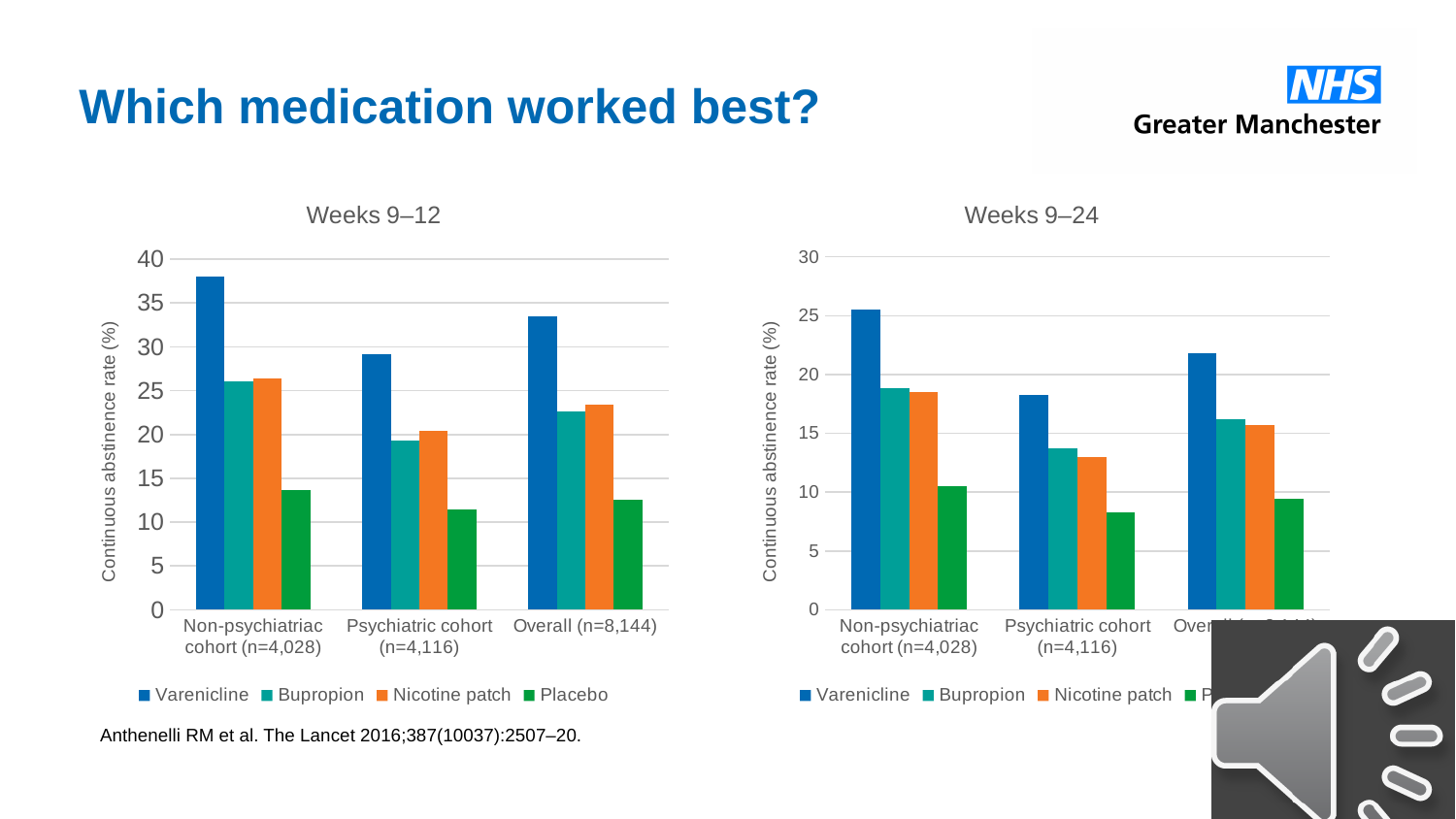
In the 'Weeks 9–24' chart, which series has the lowest value in the Non-psychiatric cohort (n=4,028)? Placebo In the 'Weeks 9–12' chart, is the Placebo value for the Psychiatric cohort (n=4,116) greater or less than 15? less In the 'Weeks 9–24' chart, is the Varenicline value for the Psychiatric cohort (n=4,116) greater or less than 20? less In the 'Weeks 9–12' chart, which medication has the highest continuous abstinence rate in the Psychiatric cohort (n=4,116)? Varenicline What is the y-axis label of the 'Weeks 9–12' chart? Continuous abstinence rate (%) In the 'Weeks 9–24' chart, is the Placebo value for Overall (n=8,144) larger or smaller than the Bupropion value for Overall (n=8,144)? smaller In the 'Weeks 9–12' chart, is the Varenicline value for the Non-psychiatric cohort (n=4,028) greater or less than 35? greater In the 'Weeks 9–12' chart, is the Varenicline value larger for the Non-psychiatric cohort (n=4,028) or the Psychiatric cohort (n=4,116)? Non-psychiatric cohort (n=4,028) What kind of chart is the 'Weeks 9–12' chart? bar chart How many series does the legend of the 'Weeks 9–12' chart list? 4 How many cohort categories are shown on the x axis of the 'Weeks 9–24' chart? 3